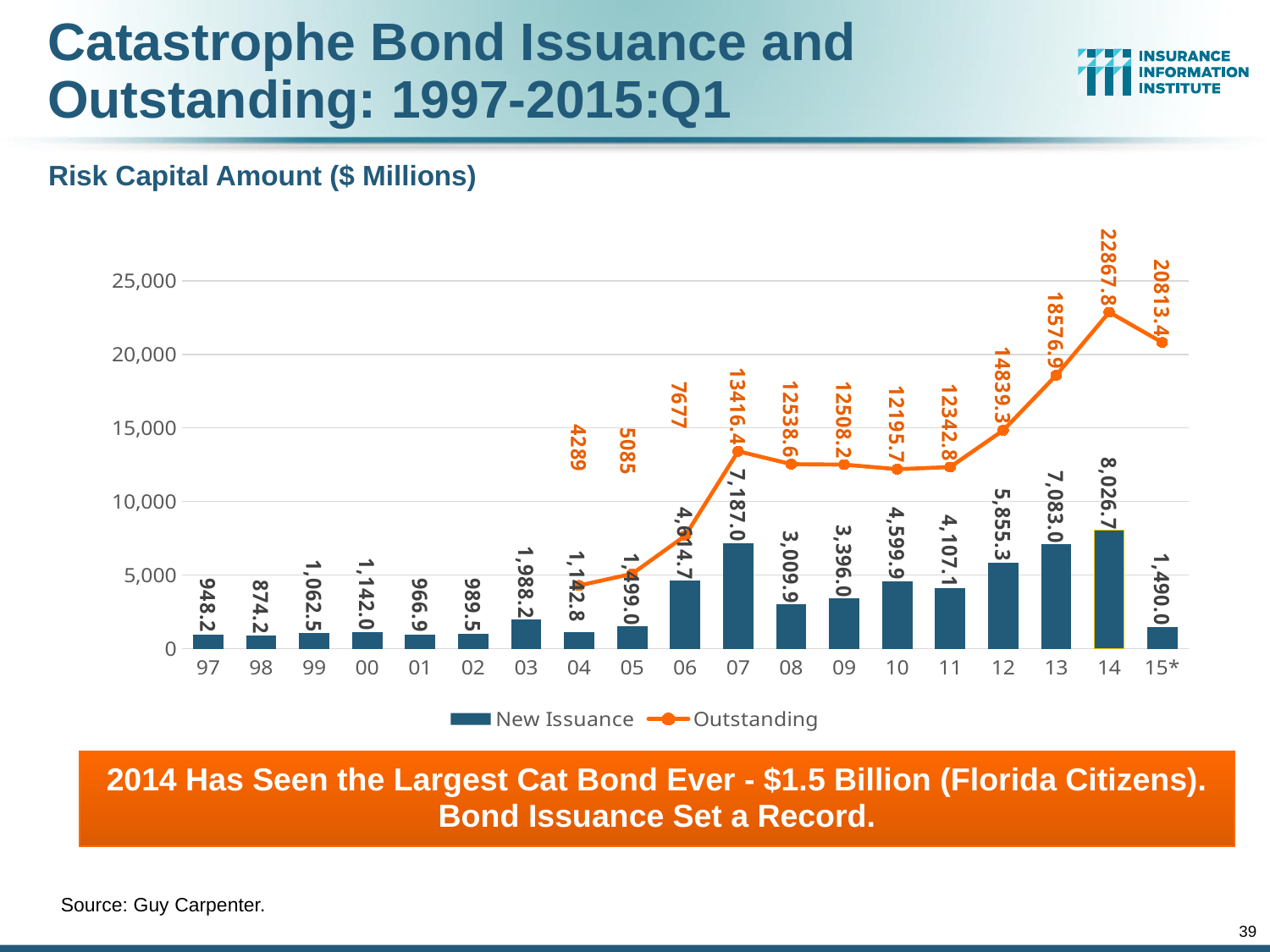
What is the New Issuance value for 2014 (14)? 8,026.7 Which year has the lowest New Issuance? 98 What is the Outstanding value for 2014 (14)? 22867.8 Is the Outstanding value for 13 greater or less than 15,000? greater Which year has the highest New Issuance? 14 How many years are shown on the x axis? 19 Does the Outstanding line rise or fall from 11 to 14? Rise Which is larger, the Outstanding value in 07 or in 12? 12 What is the difference between New Issuance in 14 and in 13? 943.7 What is the New Issuance value for 15*? 1,490.0 What kind of chart is this? Combined bar and line chart How many series does the legend list? 2